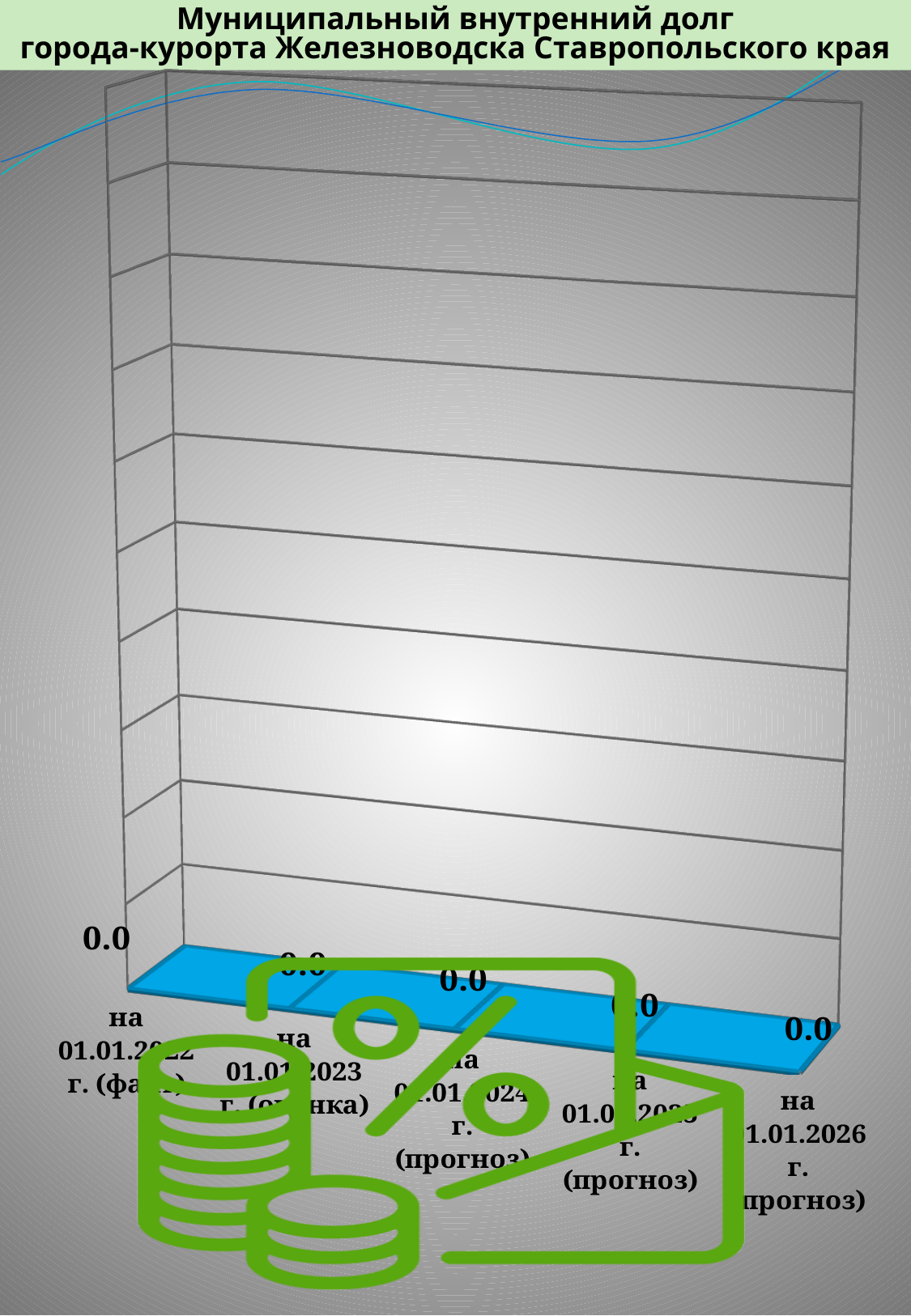
Do the values rise, fall, or stay the same across the dates from 01.01.2022 to 01.01.2026? stay the same What kind of chart is shown on the slide? area chart What is the value shown for на 01.01.2022 г. (факт)? 0.0 What is the difference between the values for на 01.01.2022 г. (факт) and на 01.01.2026 г. (прогноз)? 0.0 What is the value shown for на 01.01.2023 г. (оценка)? 0.0 Is the value for на 01.01.2025 г. (прогноз) larger than, smaller than, or equal to the value for на 01.01.2023 г. (оценка)? equal What is the title of the chart on the slide? Муниципальный внутренний долг города-курорта Железноводска Ставропольского края How many categories (dates) are plotted on the chart? 5 What is the value shown for на 01.01.2024 г. (прогноз)? 0.0 What is the value shown for на 01.01.2026 г. (прогноз)? 0.0